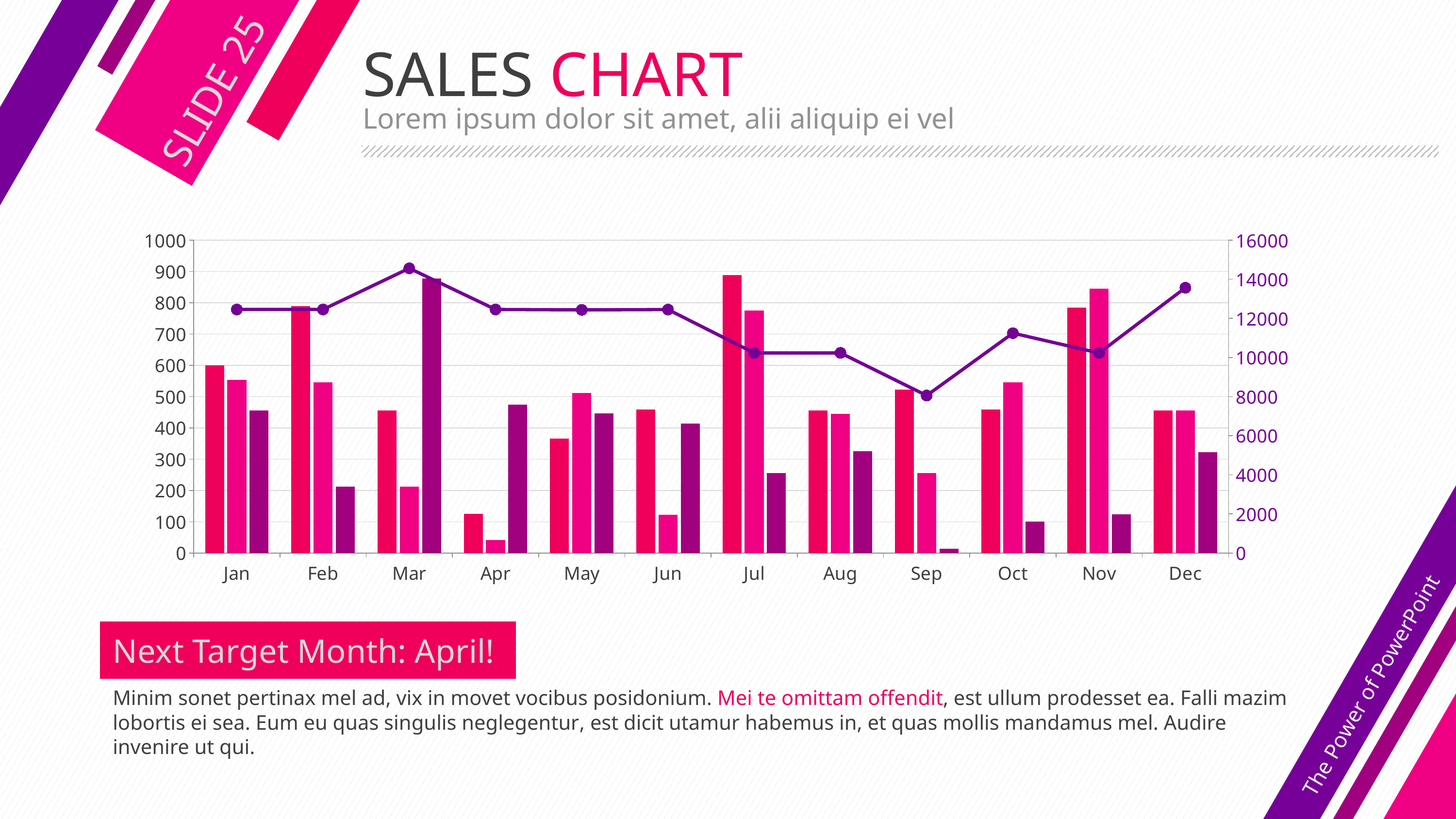
Is the leftmost bar for Jan greater or less than 500 on the left axis? greater Is the value of the line series in Sep greater or less than 10000 on the right axis? less Is the value of the line series in Mar greater or less than 14000 on the right axis? greater Is the line series value in Mar larger or smaller than in Sep? larger What is the title of the chart slide? SALES CHART In which month does the line series reach its highest point? Mar Does the line series rise or fall from Jun to Sep? fall In which month does the line series reach its lowest point? Sep What kind of chart is shown on the slide? A bar chart combined with a line chart How many months are shown along the x axis of the chart? 12 What is the maximum value shown on the right-hand axis of the chart? 16000